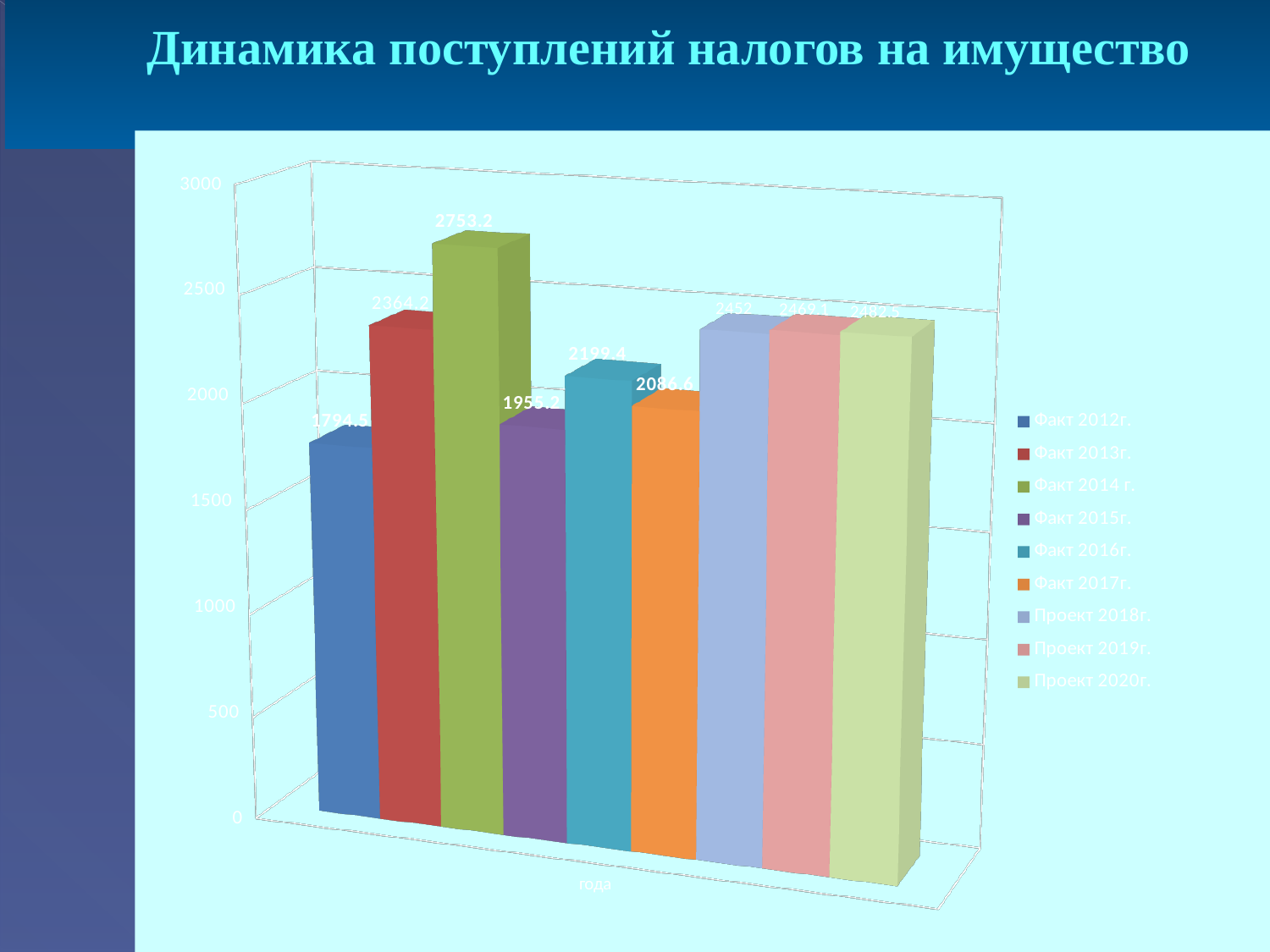
Which series has the lowest value? Факт 2012г. Which is larger, the value for Факт 2016г. or Факт 2017г.? Факт 2016г. What is the value for Факт 2015г.? 1955.2 What is the difference between the values for Факт 2014 г. and Факт 2013г.? 389 Is the value for Проект 2018г. greater or less than 2000? greater What kind of chart is shown on the slide? Bar chart Which series has the highest value? Факт 2014 г. What is the value for Факт 2012г.? 1794.5 How many series does the legend list? 9 What is the difference between the values for Факт 2016г. and Факт 2015г.? 244.2 What is the value for Факт 2014 г.? 2753.2 What is the title of the chart? Динамика поступлений налогов на имущество